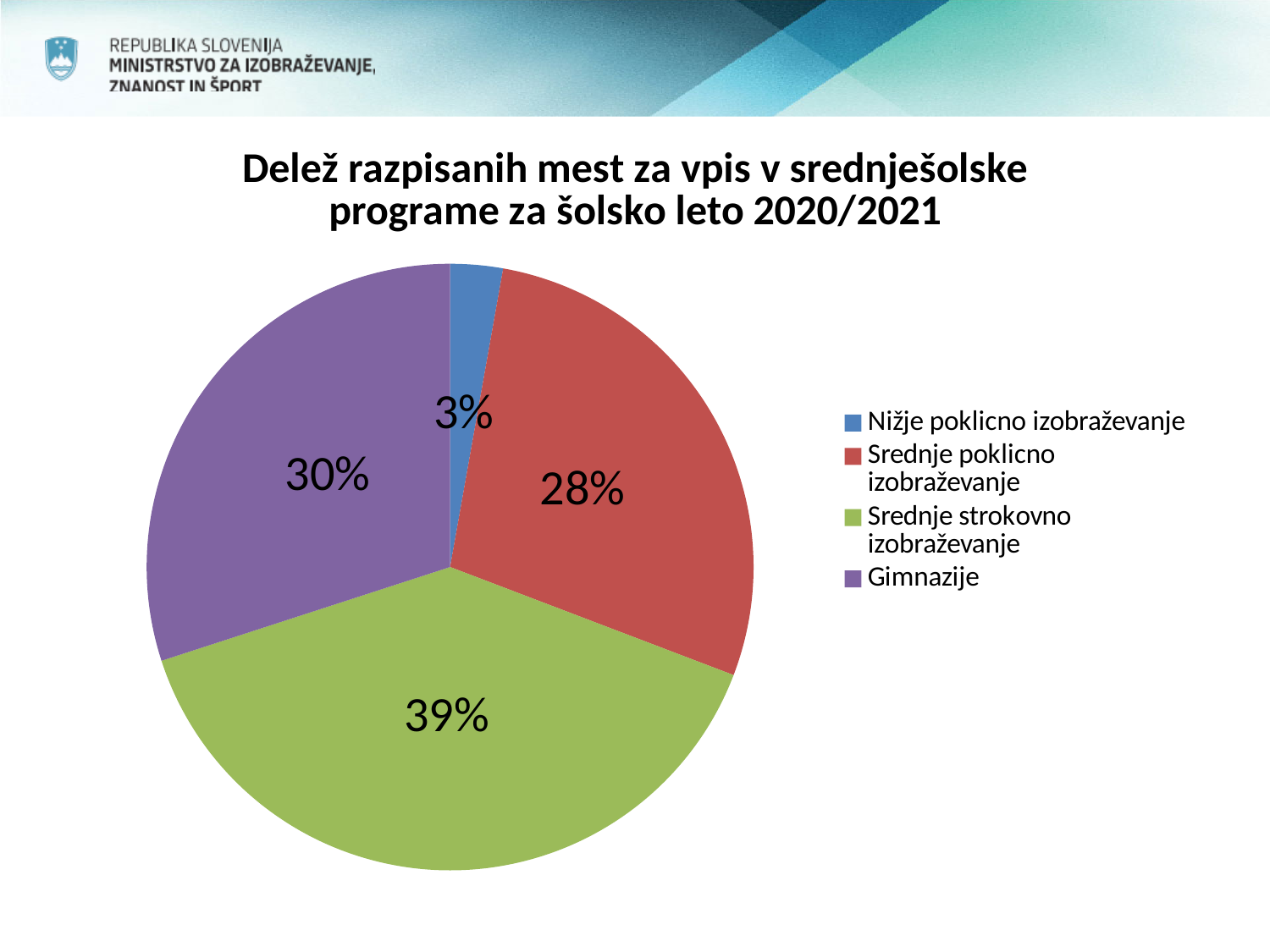
Which has a larger share, Gimnazije or Srednje poklicno izobraževanje? Gimnazije How many slices does the pie chart have? 4 Which category has the largest share of the pie? Srednje strokovno izobraževanje What share of the pie does Gimnazije have? 30% What is the difference in percentage points between the shares of Srednje strokovno izobraževanje and Gimnazije? 9 Which category has the smallest share of the pie? Nižje poklicno izobraževanje What share of the pie does Srednje strokovno izobraževanje have? 39% What share of the pie does Srednje poklicno izobraževanje have? 28% Which colour represents Gimnazije in the pie chart? purple What is the title of the chart? Delež razpisanih mest za vpis v srednješolske programe za šolsko leto 2020/2021 What kind of chart is shown on the slide? pie chart